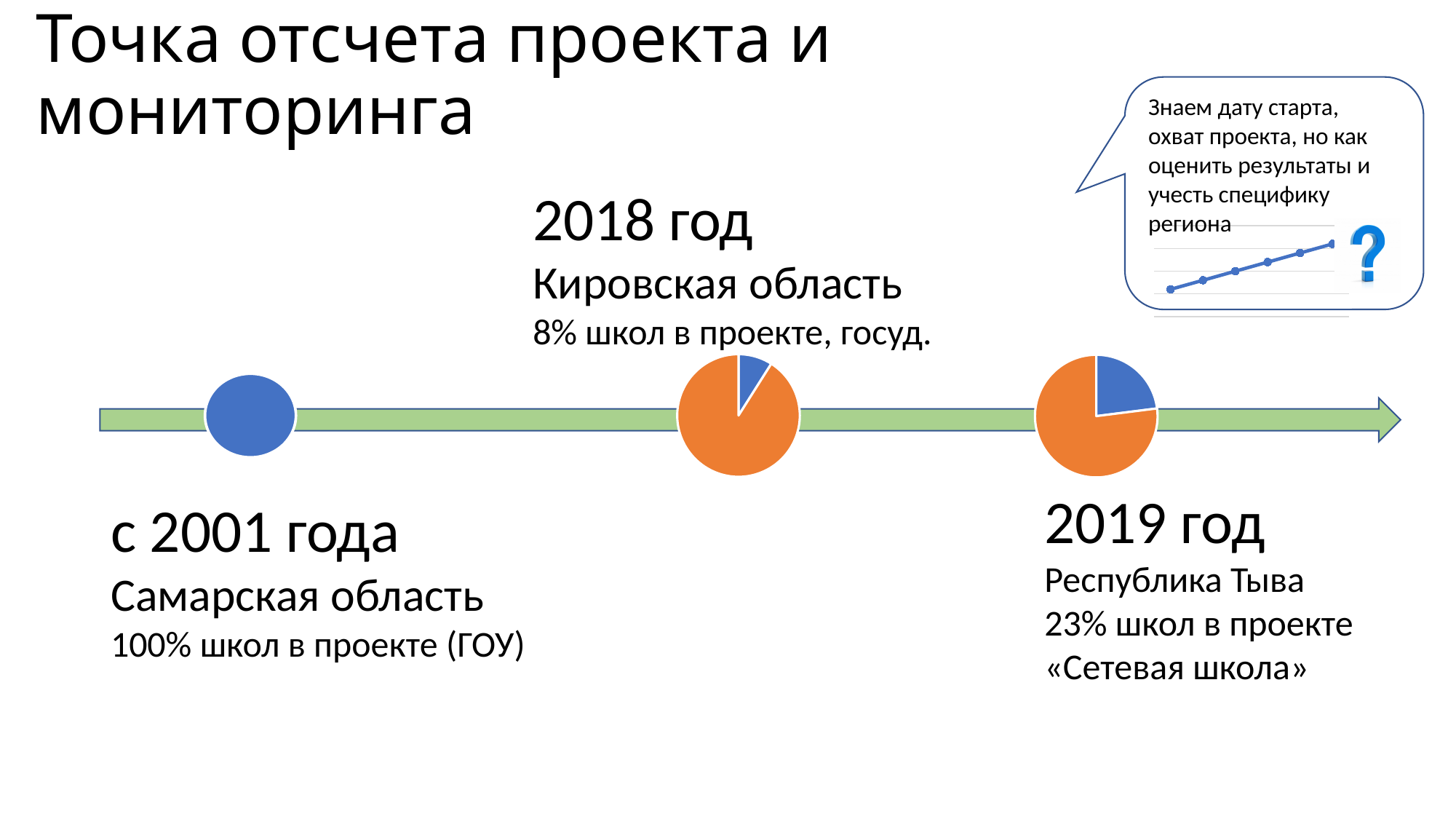
Is the share of schools in the project larger for Республика Тыва (2019) or Кировская область (2018)? Республика Тыва Which region's pie chart shows the largest share of schools in the project? Самарская область In the 2001 chart (Самарская область), what share of schools is in the project? 100% What is the difference between the share of schools in the project in Самарская область (100%) and Республика Тыва (23%)? 77% What is the difference between the share of schools in the project in Республика Тыва (23%) and Кировская область (8%)? 15% In the 2019 pie chart (Республика Тыва), what share of schools is in the project? 23% What colour is the slice representing schools in the project in the 2018 and 2019 pie charts? blue How many pie charts are placed on the timeline? 2 Which region's pie chart shows the smallest share of schools in the project? Кировская область In the 2018 pie chart (Кировская область), what share of schools is in the project? 8% What kind of chart is shown inside the speech bubble in the top right corner? line chart What kind of chart is shown on the timeline for 2018 (Кировская область)? pie chart